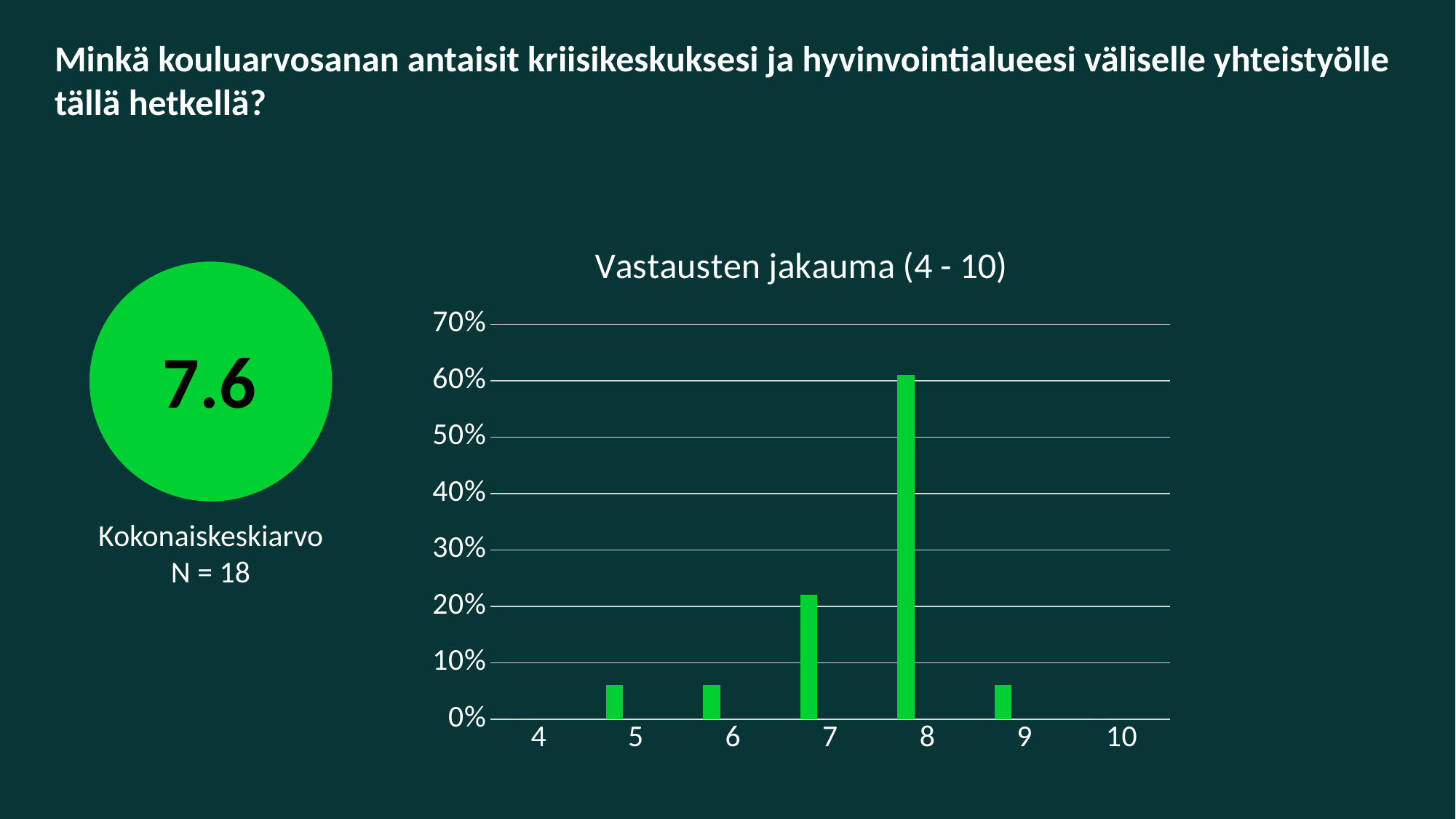
Which grade has the highest share of responses in the chart? 8 Which has a larger value, grade 7 or grade 8? 8 Is the value for grade 5 greater or less than 10%? less What kind of chart is shown on the slide? bar chart Which has a larger value, grade 6 or grade 7? 7 Is the value for grade 9 greater or less than 10%? less Is the value for grade 7 greater or less than 10%? greater What overall average (Kokonaiskeskiarvo) is shown in the circle next to the chart? 7.6 How many grade categories are shown on the x axis of the chart? 7 What is the title of the chart? Vastausten jakauma (4 - 10)